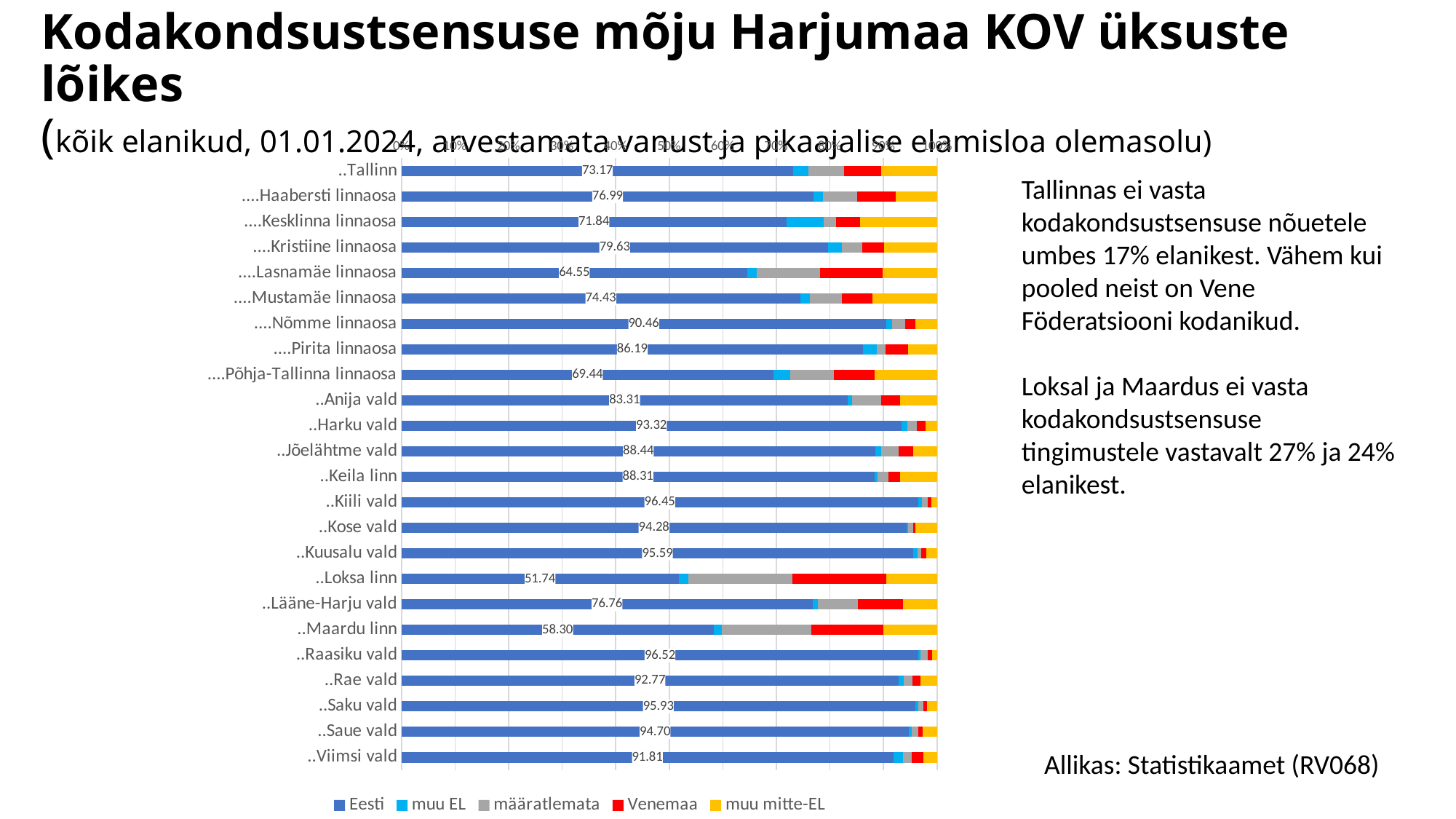
What kind of chart is shown on the slide? stacked bar chart How many series does the legend list? 5 What is the difference between the Eesti values for Tallinn and Loksa linn? 21.43 Which category has the lowest Eesti value? Loksa linn What is the Eesti value for Maardu linn? 58.30 What is the Eesti value for Lasnamäe linnaosa? 64.55 Which has a larger Eesti value, Lasnamäe linnaosa or Põhja-Tallinna linnaosa? Põhja-Tallinna linnaosa Is the Eesti value for Maardu linn greater or less than 60%? less Which series is shown in red in the legend? Venemaa How many categories are shown on the chart? 24 What is the Eesti value for Loksa linn? 51.74 What is the Eesti value for Tallinn? 73.17